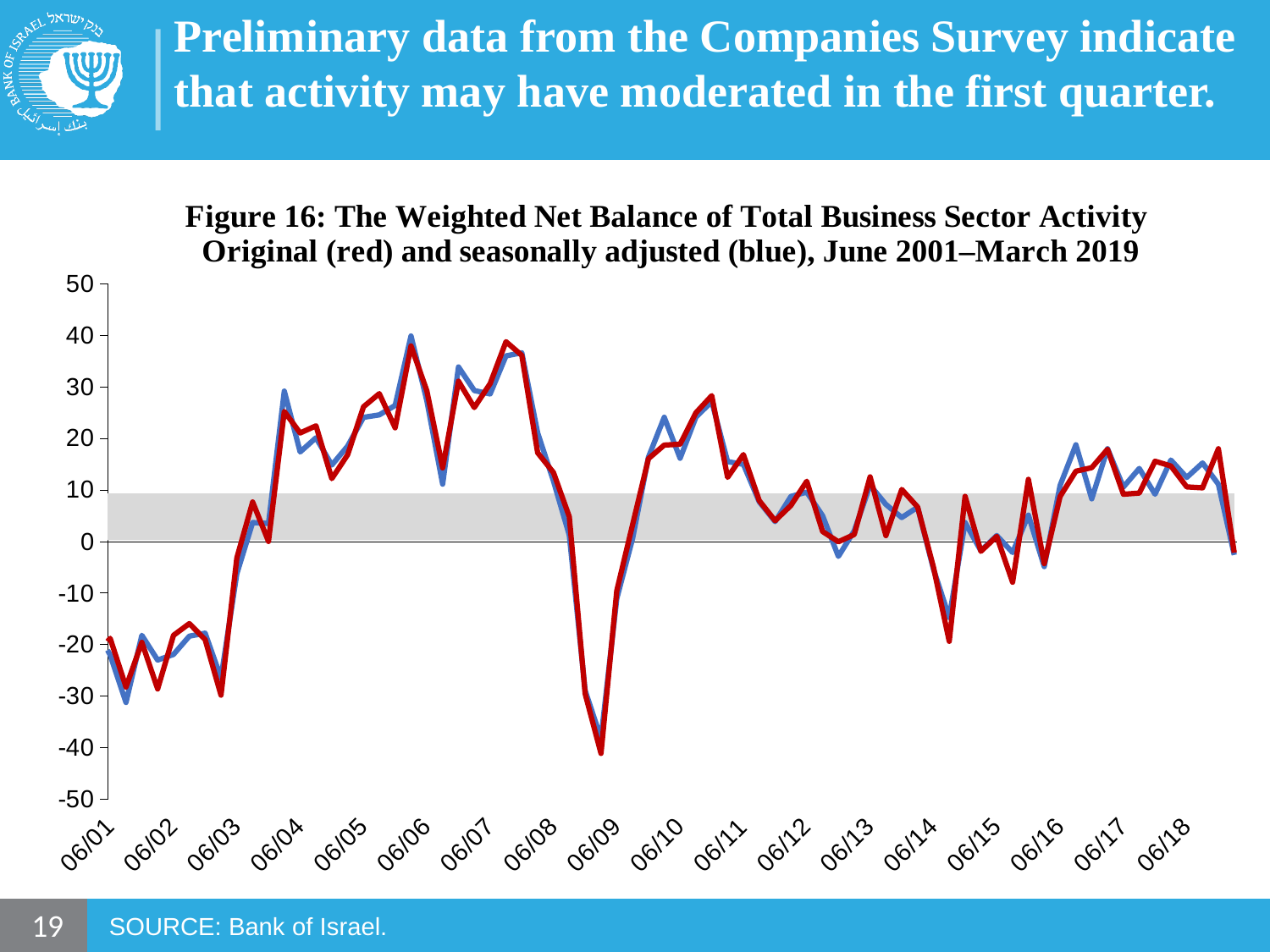
Do the values rise or fall between 06/08 and 06/09? fall How many data series are plotted in Figure 16? 2 Near which x-axis label does the highest point of the blue line occur? 06/06 Is the value of the red line at 06/01 greater or less than -10? less Which series is drawn in red in Figure 16? Original How many date labels are shown on the x axis? 18 Which series is drawn in blue in Figure 16? Seasonally adjusted Near which x-axis label does the lowest point of the red line occur? 06/09 What kind of chart is shown on the slide? line chart